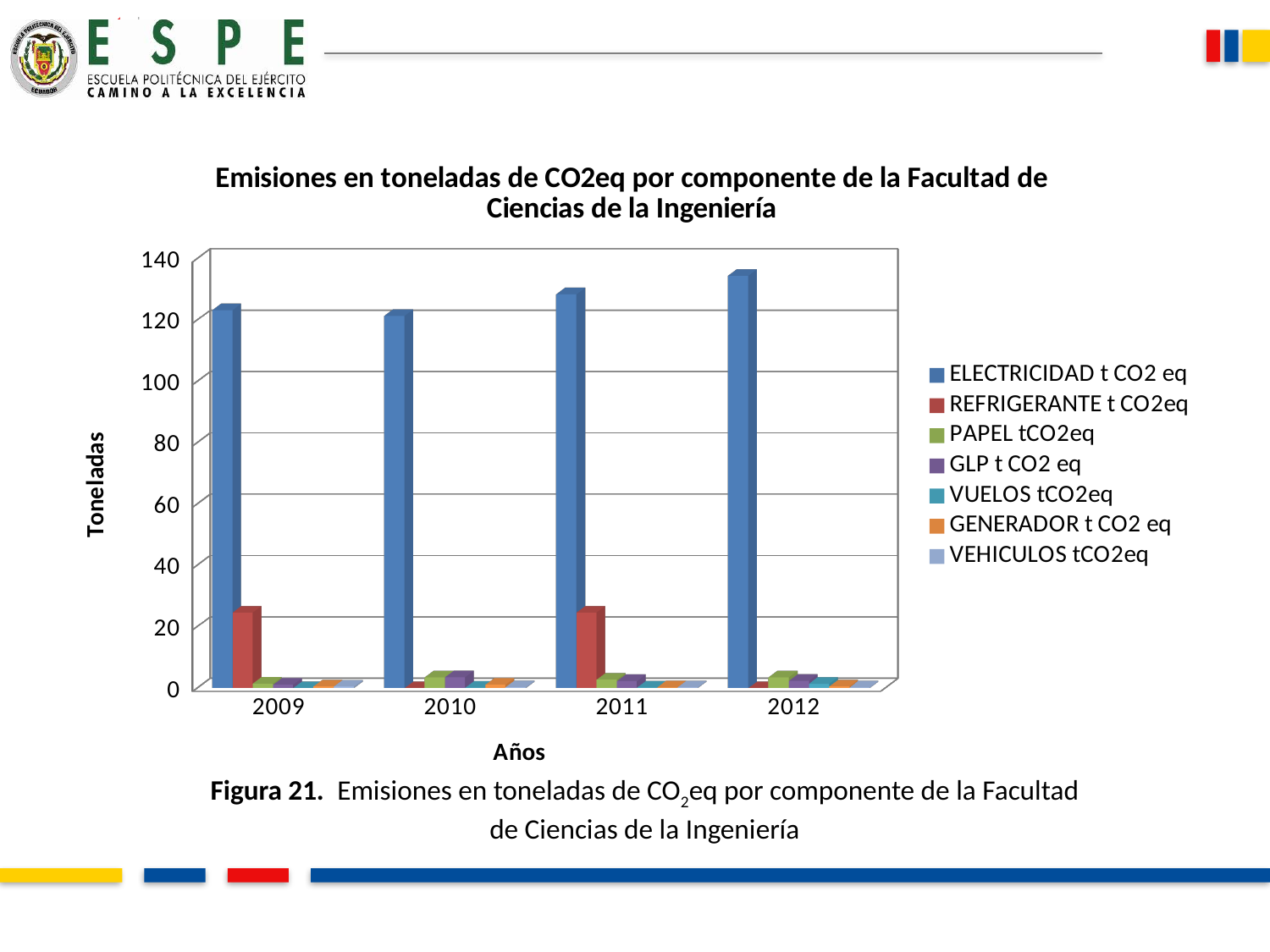
Is the REFRIGERANTE t CO2eq value for 2010 greater or less than 20? less How many years are shown on the x axis of the chart? 4 What is the label of the vertical axis of the chart? Toneladas Which year has the larger REFRIGERANTE t CO2eq value, 2009 or 2010? 2009 Is the ELECTRICIDAD t CO2 eq value for 2012 greater or less than 120? greater How many series does the chart legend list? 7 In which year is the ELECTRICIDAD t CO2 eq value highest? 2012 Is the REFRIGERANTE t CO2eq value for 2009 greater or less than 20? greater Which series has the highest value in every year shown? ELECTRICIDAD t CO2 eq What kind of chart is shown on the slide? bar chart Which year has the larger ELECTRICIDAD t CO2 eq value, 2011 or 2012? 2012 Does the ELECTRICIDAD t CO2 eq value rise or fall from 2010 to 2012? rise